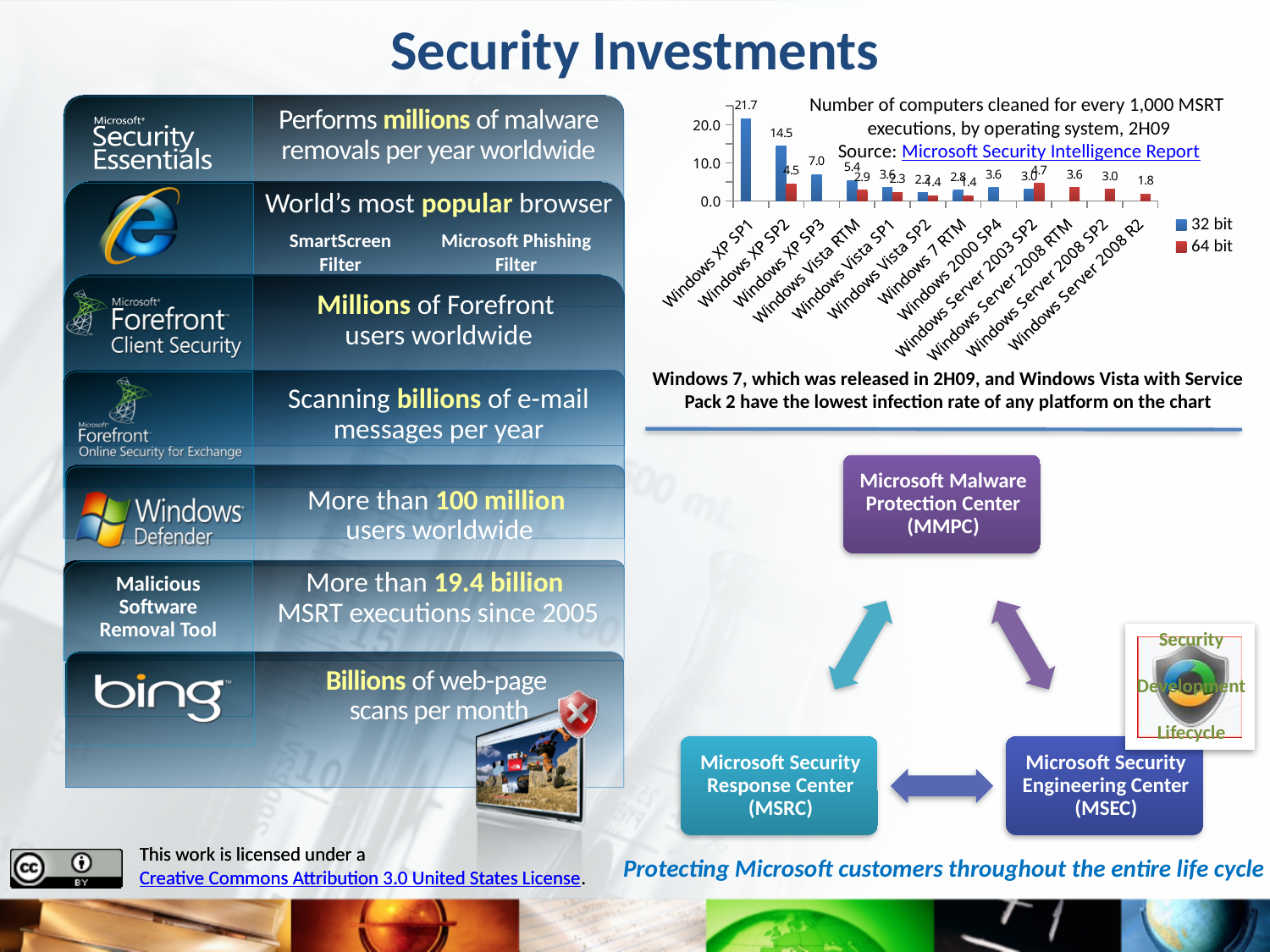
Which is larger, the 32 bit value for Windows XP SP2 or the 32 bit value for Windows XP SP3? Windows XP SP2 Which operating system has the highest 32 bit value in the chart? Windows XP SP1 How many operating systems are shown along the x axis of the chart? 12 What kind of chart is shown on the slide? bar chart What is the 64 bit value for Windows XP SP2? 4.5 What are the two series named in the chart legend? 32 bit and 64 bit Is the 32 bit value for Windows XP SP3 greater or less than 10.0? less Do the 32 bit values rise or fall going from Windows XP SP1 to Windows XP SP2 to Windows XP SP3? fall How many series does the chart legend list? 2 What is the 32 bit value for Windows XP SP1? 21.7 What is the 32 bit value for Windows Vista RTM? 5.4 What is the difference between the 32 bit values for Windows XP SP1 and Windows XP SP2? 7.2